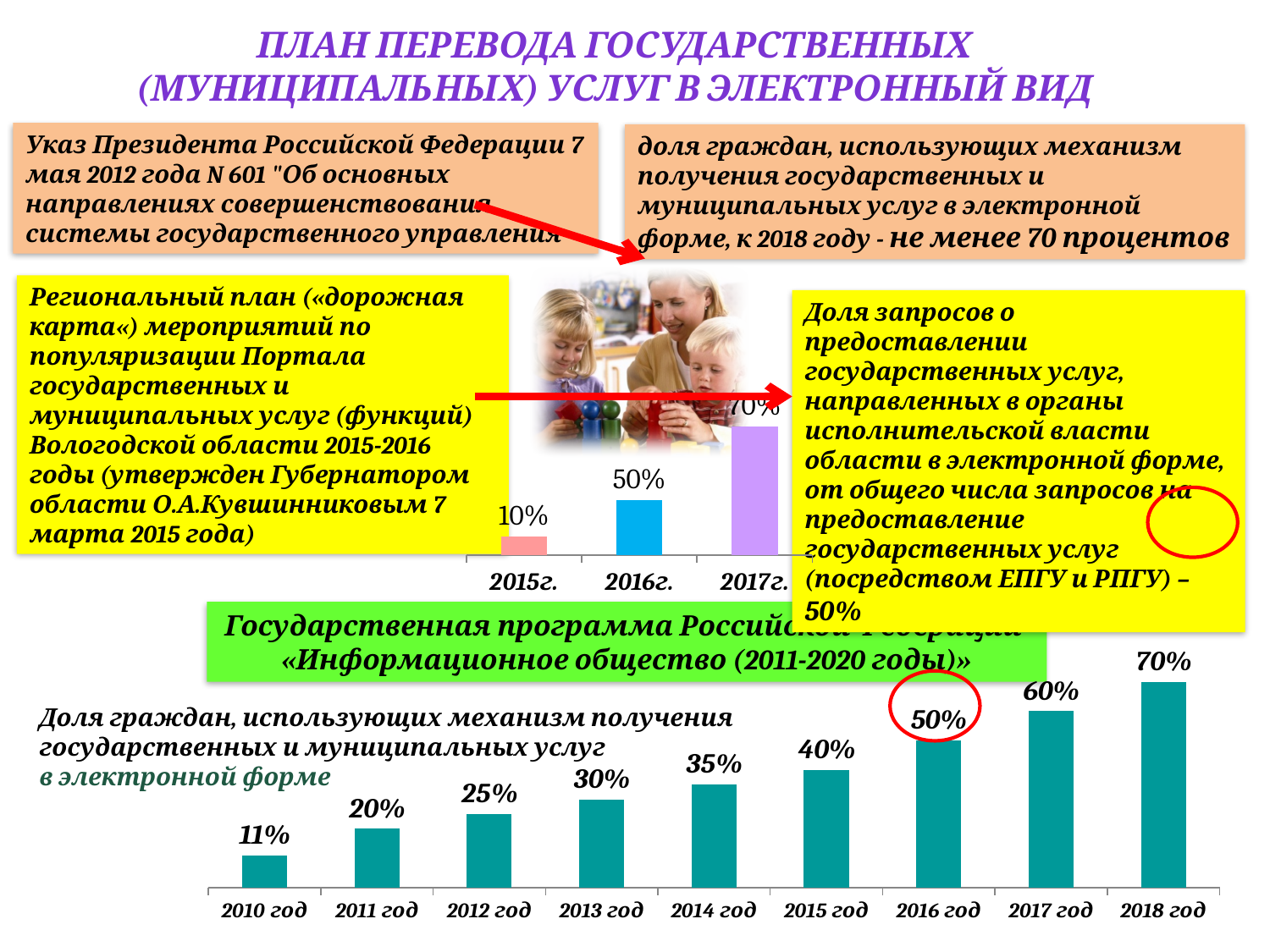
In the bottom chart, what is the difference between the values for 2018 год and 2010 год? 59% In the bottom chart, which year has the lowest value? 2010 год In the small chart in the middle of the slide, which year has the highest value? 2017г. What kind of chart is the bottom chart? bar chart In the bottom chart, which year has the highest value? 2018 год In the bottom chart, what is the value for 2017 год? 60% In the small chart in the middle of the slide, what is the value for 2016г.? 50% In the small chart in the middle of the slide, what is the value for 2015г.? 10% In the bottom chart, what is the value for 2010 год? 11% In the bottom chart, how many years are shown on the x axis? 9 In the bottom chart, what is the value for 2014 год? 35% In the bottom chart, do the values rise or fall from 2010 год to 2018 год? rise